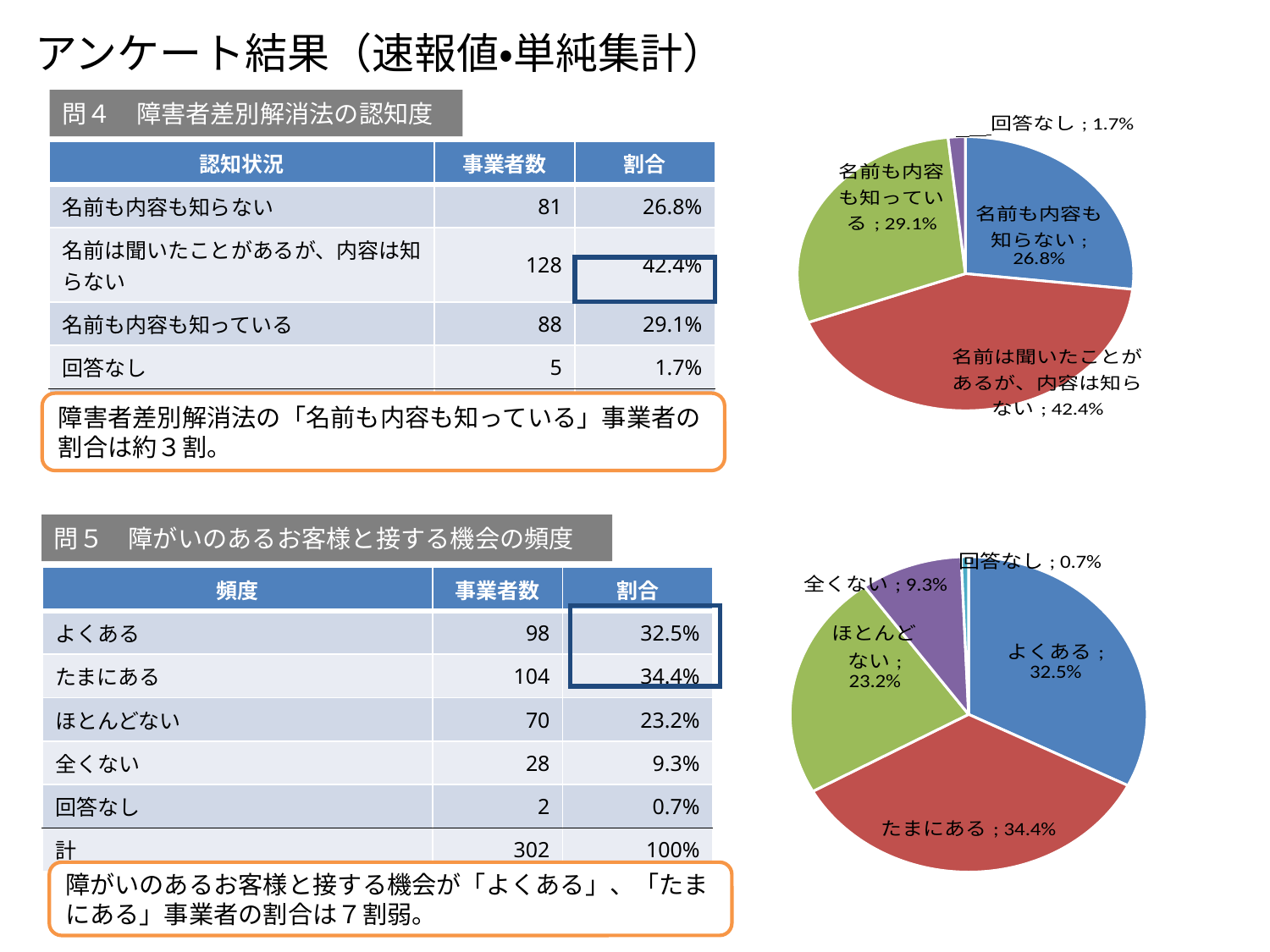
In the top pie chart (問4), what share is labelled for 名前は聞いたことがあるが、内容は知らない? 42.4% In the top pie chart (問4), which category has the largest slice? 名前は聞いたことがあるが、内容は知らない In the bottom pie chart (問5), which category has the largest slice? たまにある In the top pie chart (問4), which category has the smallest slice? 回答なし In the bottom pie chart (問5), what share is labelled for 全くない? 9.3% What type of chart is used for 問5 on the right side of the slide? Pie chart How many slices does the bottom pie chart (問5) have? 5 In the top pie chart (問4), what share is labelled for 回答なし? 1.7% How many slices does the top pie chart (問4) have? 4 In the bottom pie chart (問5), what share is labelled for ほとんどない? 23.2% In the bottom pie chart (問5), which is larger, the share for よくある or the share for ほとんどない? よくある In the top pie chart (問4), what is the difference between the shares for 名前も内容も知っている and 名前も内容も知らない? 2.3%